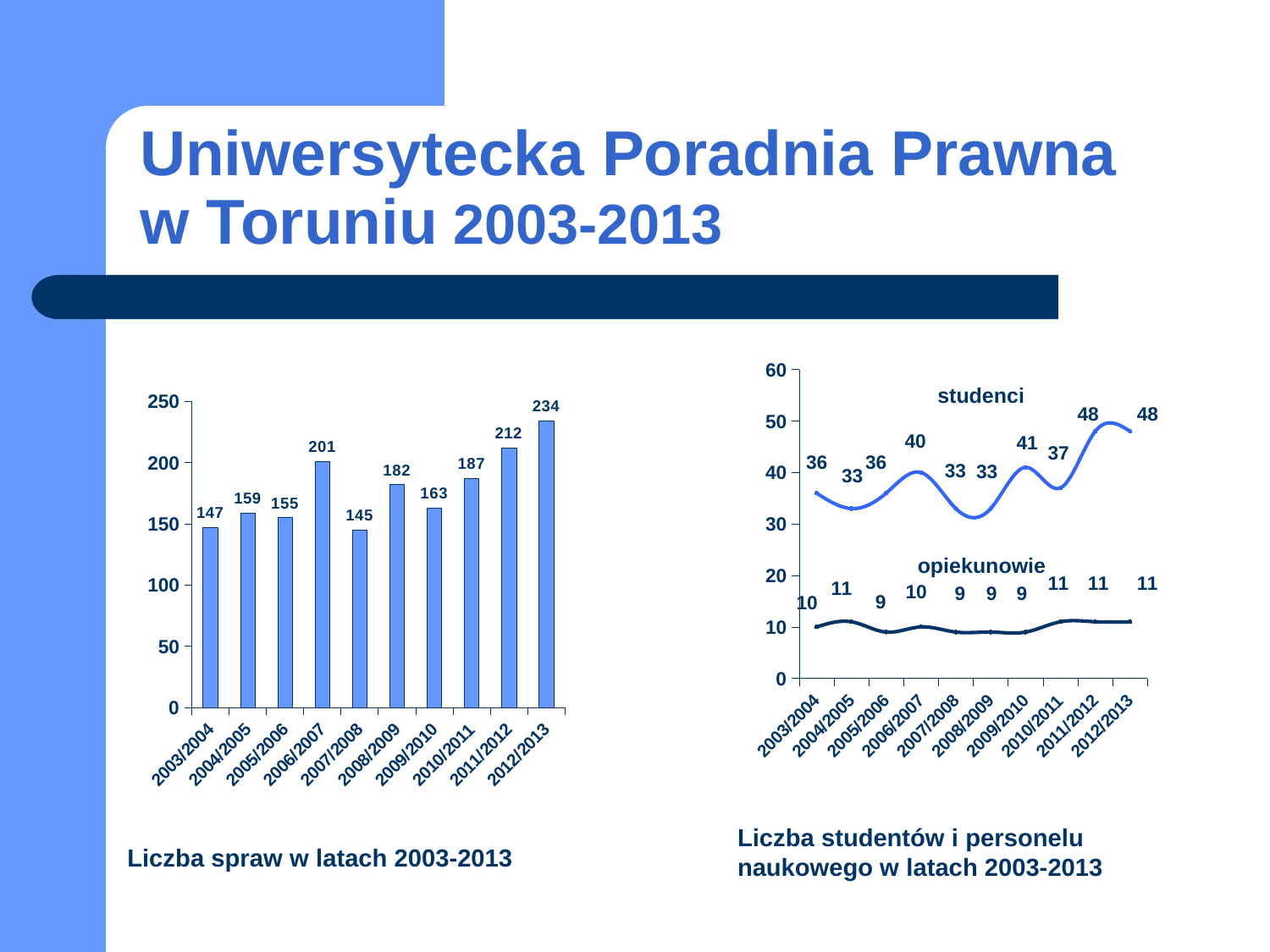
In the left chart (Liczba spraw w latach 2003-2013), what is the difference between the values for 2012/2013 and 2003/2004? 87 What kind of chart is the left chart (Liczba spraw w latach 2003-2013)? bar chart In the right chart (Liczba studentów i personelu naukowego w latach 2003-2013), what is the value for opiekunowie in 2004/2005? 11 In the right chart (Liczba studentów i personelu naukowego w latach 2003-2013), how many series are plotted? 2 In the right chart (Liczba studentów i personelu naukowego w latach 2003-2013), what is the value for studenci in 2009/2010? 41 In the left chart (Liczba spraw w latach 2003-2013), which year has the lowest value? 2007/2008 In the left chart (Liczba spraw w latach 2003-2013), what is the value for 2006/2007? 201 In the left chart (Liczba spraw w latach 2003-2013), which year has the highest value? 2012/2013 In the left chart (Liczba spraw w latach 2003-2013), which is larger: the value for 2008/2009 or the value for 2009/2010? 2008/2009 In the left chart (Liczba spraw w latach 2003-2013), how many bars are there? 10 What kind of chart is the right chart (Liczba studentów i personelu naukowego w latach 2003-2013)? line chart In the right chart (Liczba studentów i personelu naukowego w latach 2003-2013), what is the difference between studenci and opiekunowie in 2012/2013? 37